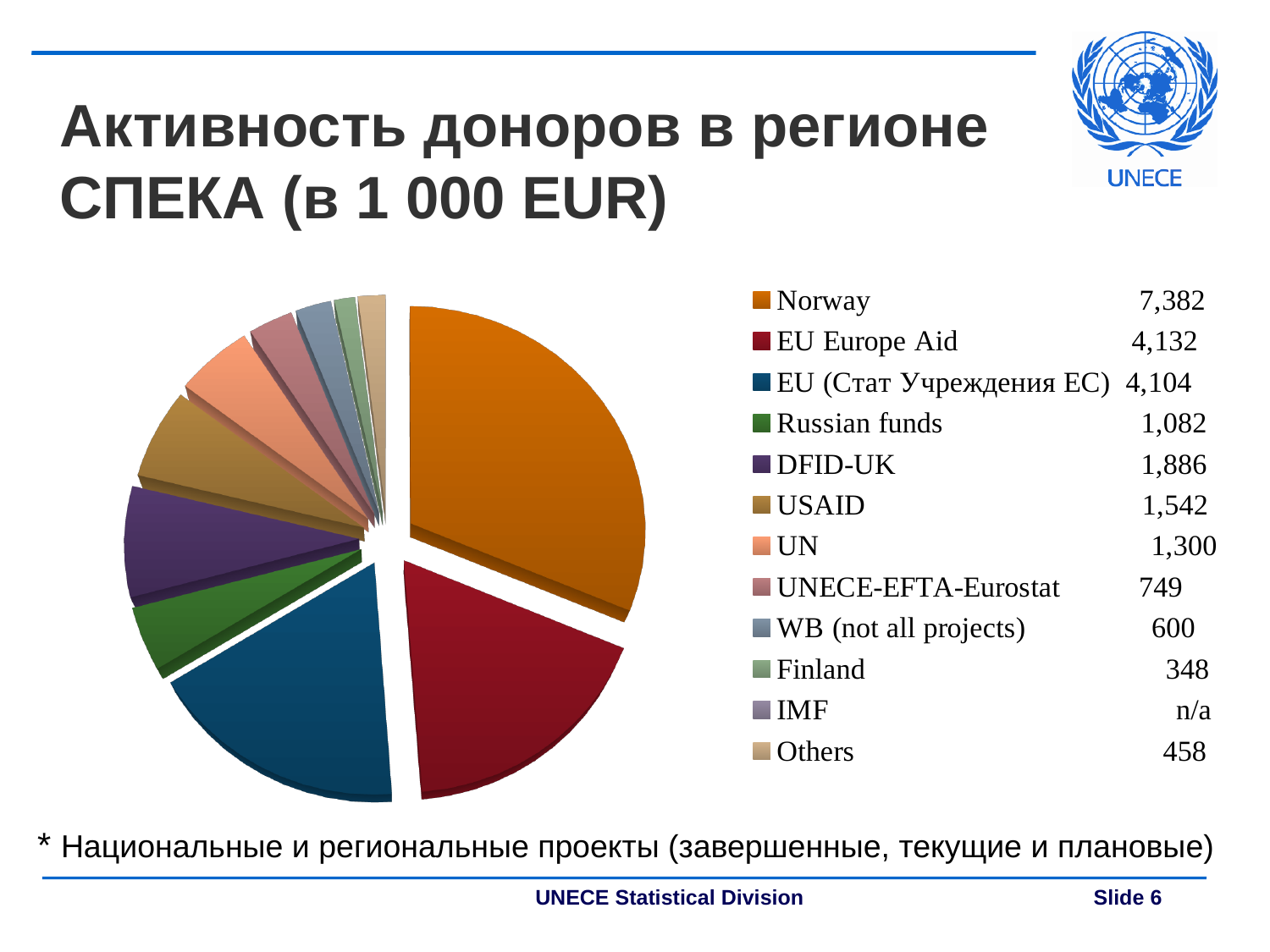
What value is shown for Norway? 7,382 What value is shown for DFID-UK? 1,886 Which donor has the highest value? Norway How many entries does the legend list? 12 What value is shown for IMF in the legend? n/a What is the difference between the values for Norway and EU Europe Aid? 3,250 What value is shown for Others? 458 What kind of chart is shown on the slide? Pie chart What is the difference between the values for USAID and UN? 242 Which donor with a numeric value has the lowest value? Finland Which is larger, the value for DFID-UK or the value for USAID? DFID-UK What value is shown for UNECE-EFTA-Eurostat? 749